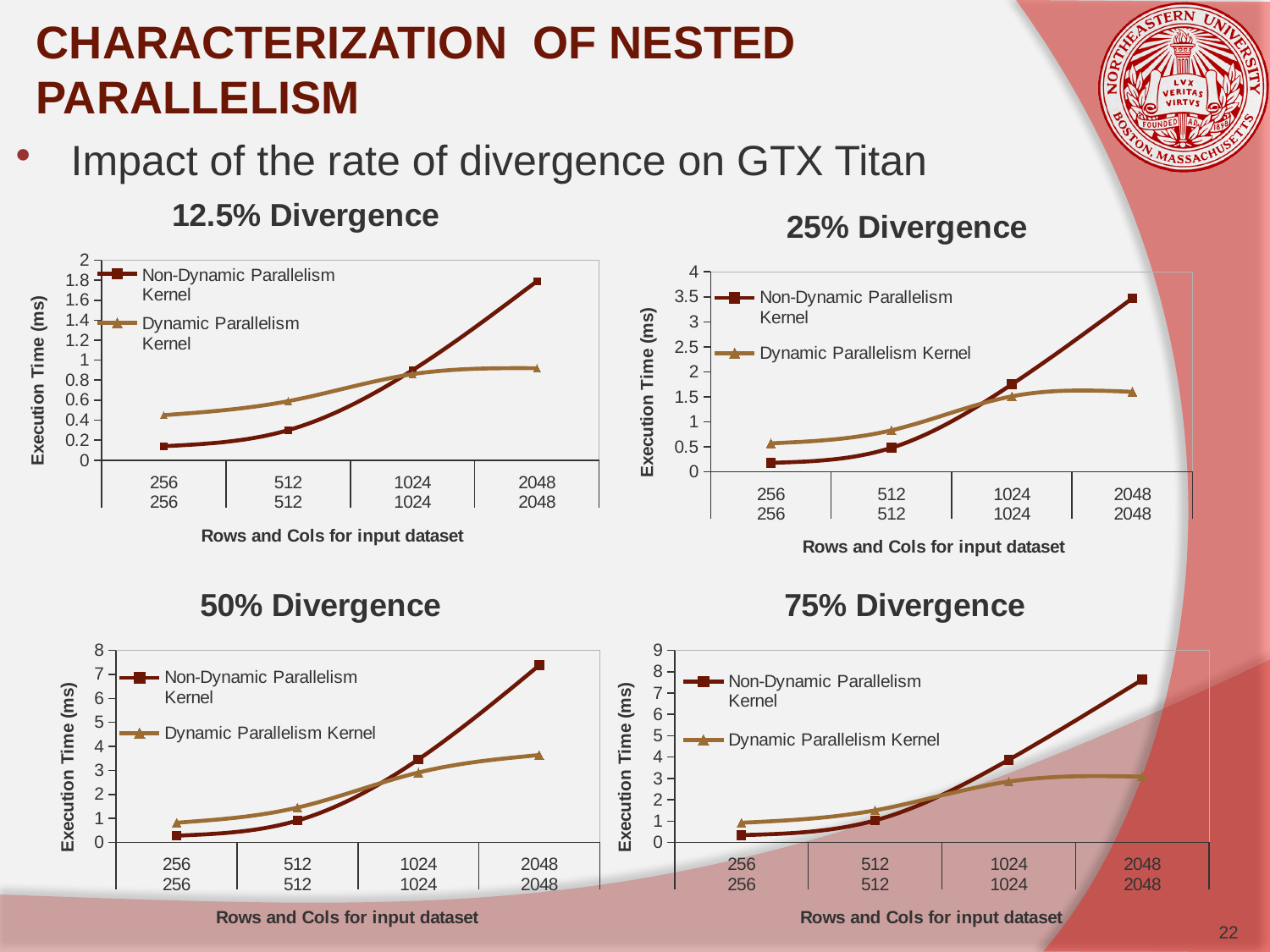
In the 12.5% Divergence chart, what is the x-axis title? Rows and Cols for input dataset In the 75% Divergence chart, what is the y-axis title? Execution Time (ms) In the 25% Divergence chart, does the Non-Dynamic Parallelism Kernel execution time rise or fall as the dataset size increases? rises In the 75% Divergence chart, which series has the higher execution time at 256 x 256? Dynamic Parallelism Kernel In the 25% Divergence chart, how many series does the legend list? 2 In the 50% Divergence chart, which series has the higher execution time at 2048 x 2048? Non-Dynamic Parallelism Kernel In the 12.5% Divergence chart, is the Non-Dynamic Parallelism Kernel value at 2048 x 2048 greater or less than 1? greater In the 12.5% Divergence chart, what kind of chart is shown? line chart In the 50% Divergence chart, how many input dataset sizes are plotted along the x axis? 4 In the 25% Divergence chart, is the Dynamic Parallelism Kernel value at 2048 x 2048 greater or less than 2? less In the 50% Divergence chart, is the Dynamic Parallelism Kernel value at 256 x 256 greater or less than 2? less